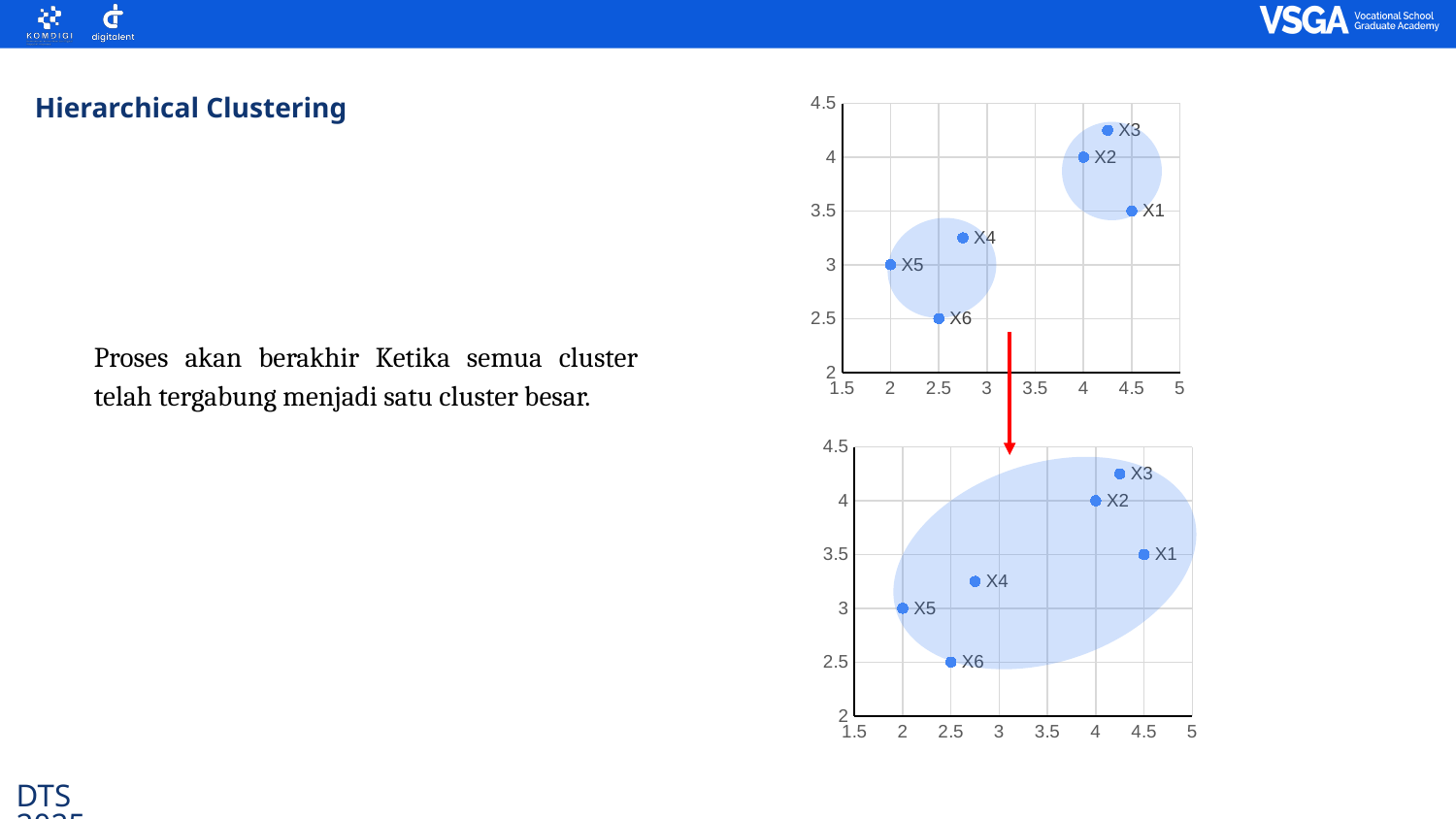
In the bottom chart, what is the y value of point X2? 4 In the top chart, which point has the lowest y value? X6 How many data points are plotted in the top chart? 6 In the bottom chart, is the x value of X3 greater or less than 4? greater In the bottom chart, which point has the highest x value? X1 In the top chart, what is the x value of point X5? 2 What kind of chart is the top chart on the slide? scatter chart In the bottom chart, which point has the lowest x value? X5 In the top chart, is the y value of X4 greater or less than 3? greater How many shaded cluster regions are drawn in the top chart? 2 In the top chart, which point has a larger y value, X1 or X2? X2 In the top chart, which point has the highest y value? X3